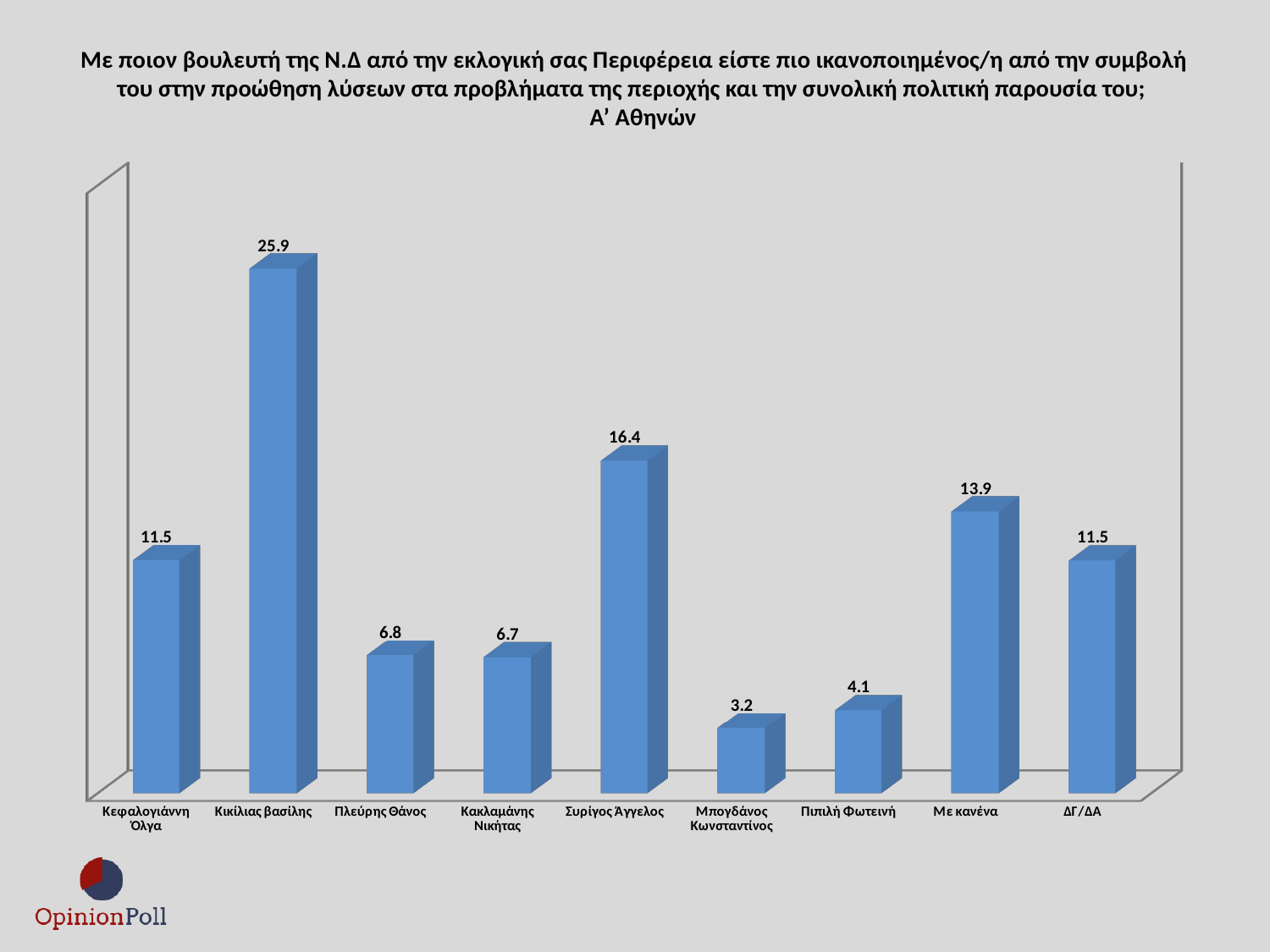
What is the value for Κικίλιας βασίλης? 25.9 What is the value for Μπογδάνος Κωνσταντίνος? 3.2 What kind of chart is shown on the slide? bar chart Which category has the lowest value? Μπογδάνος Κωνσταντίνος What is the value for Με κανένα? 13.9 What is the value for Συρίγος Άγγελος? 16.4 Which category has the highest value? Κικίλιας βασίλης Which two categories share the same value of 11.5? Κεφαλογιάννη Όλγα and ΔΓ/ΔΑ Which is larger, the value for Πλεύρης Θάνος or the value for Πιπιλή Φωτεινή? Πλεύρης Θάνος What is the difference between the values for Κικίλιας βασίλης and Συρίγος Άγγελος? 9.5 What is the difference between the values for Με κανένα and ΔΓ/ΔΑ? 2.4 How many categories are shown on the x axis? 9